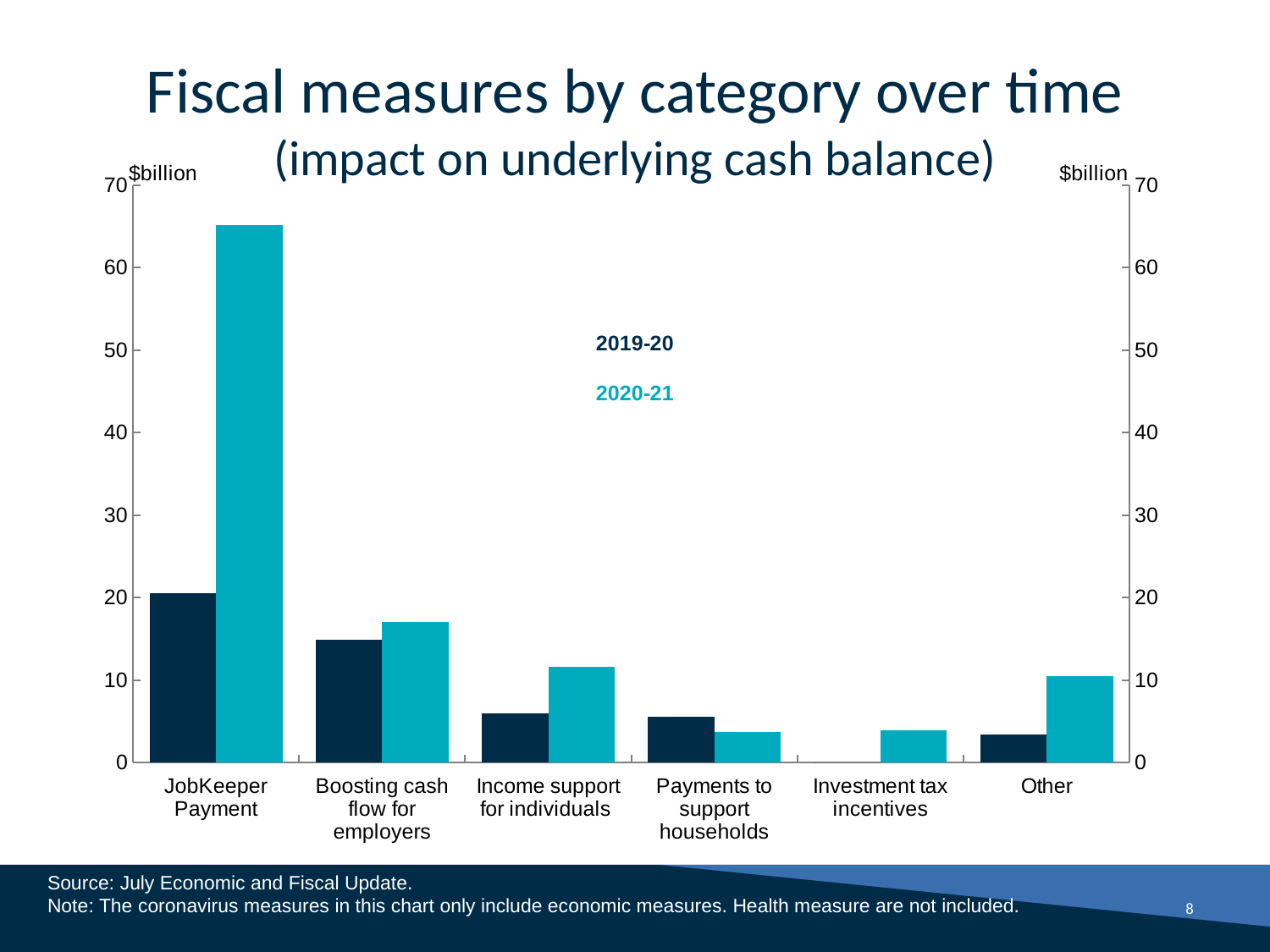
Is the 2019-20 value for JobKeeper Payment greater or less than 30? less Is the 2020-21 value for Boosting cash flow for employers greater or less than 20? less What unit is shown on the chart's vertical axis? $billion Which category has the highest 2019-20 value? JobKeeper Payment What kind of chart is shown on the slide? Bar chart Which category has the highest 2020-21 value? JobKeeper Payment How many categories are shown on the x axis of the chart? 6 How many series does the chart's legend list? 2 For JobKeeper Payment, which series has the larger value, 2019-20 or 2020-21? 2020-21 Is the 2020-21 value for JobKeeper Payment greater or less than 60? greater For Payments to support households, which series has the larger value, 2019-20 or 2020-21? 2019-20